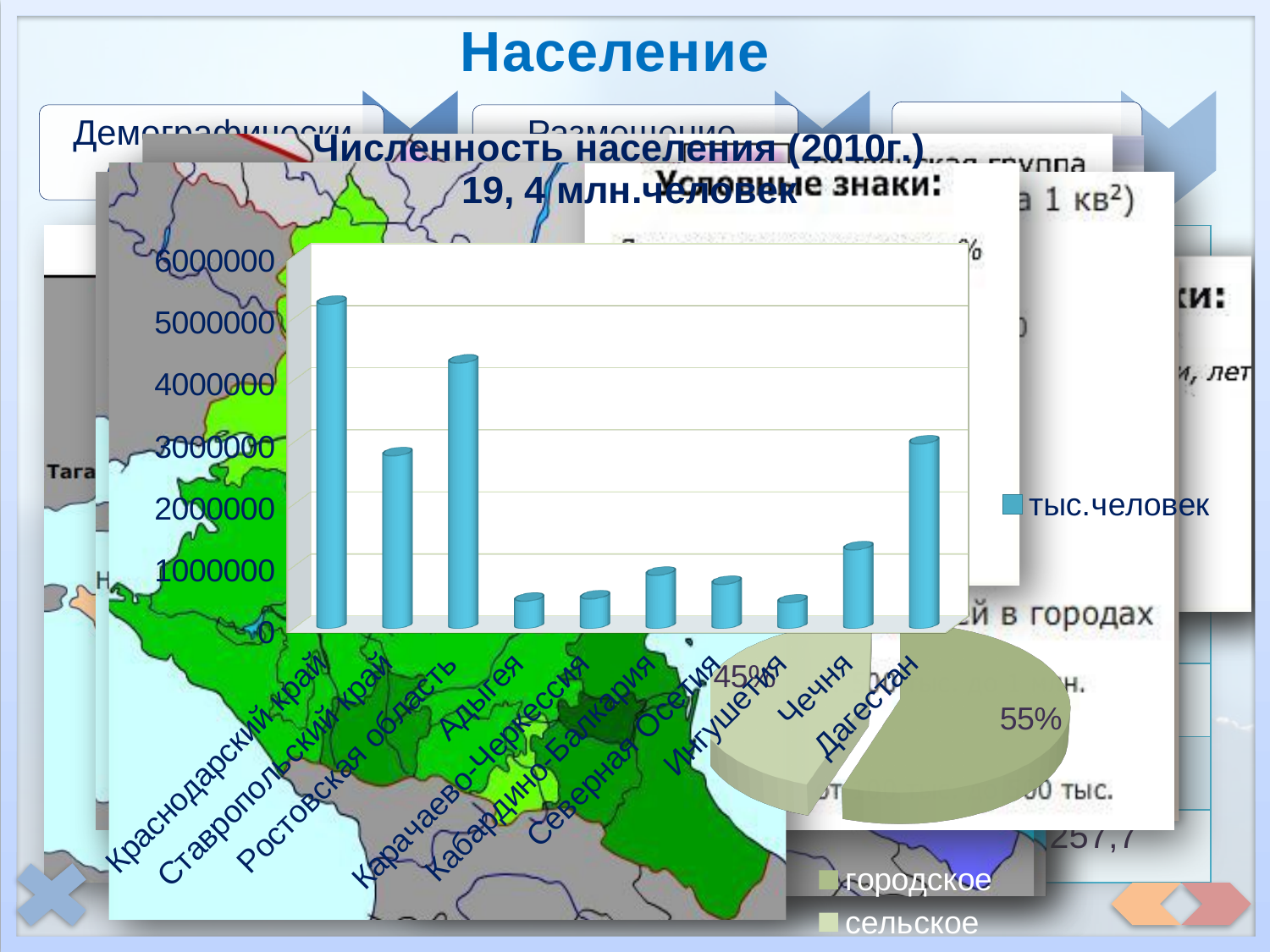
On the bar chart 'Численность населения (2010г.)', which is larger, the value for Ростовская область or Ставропольский край? Ростовская область On the bar chart 'Численность населения (2010г.)', is the value for Ставропольский край greater or less than 3000000? less On the bar chart 'Численность населения (2010г.)', is the value for Краснодарский край greater or less than 5000000? greater On the bar chart 'Численность населения (2010г.)', how many regions are shown on the x axis? 10 What kind of chart is the chart titled 'Численность населения (2010г.)'? bar chart On the bar chart 'Численность населения (2010г.)', which region has the highest value? Краснодарский край On the bar chart 'Численность населения (2010г.)', is the value for Ростовская область greater or less than 4000000? greater On the bar chart 'Численность населения (2010г.)', which is larger, the value for Чечня or Ингушетия? Чечня On the bar chart 'Численность населения (2010г.)', how many series does the legend list? 1 On the pie chart at the bottom right, what share is labelled for городское? 55% On the bar chart 'Численность населения (2010г.)', what is the legend entry for the series? тыс.человек